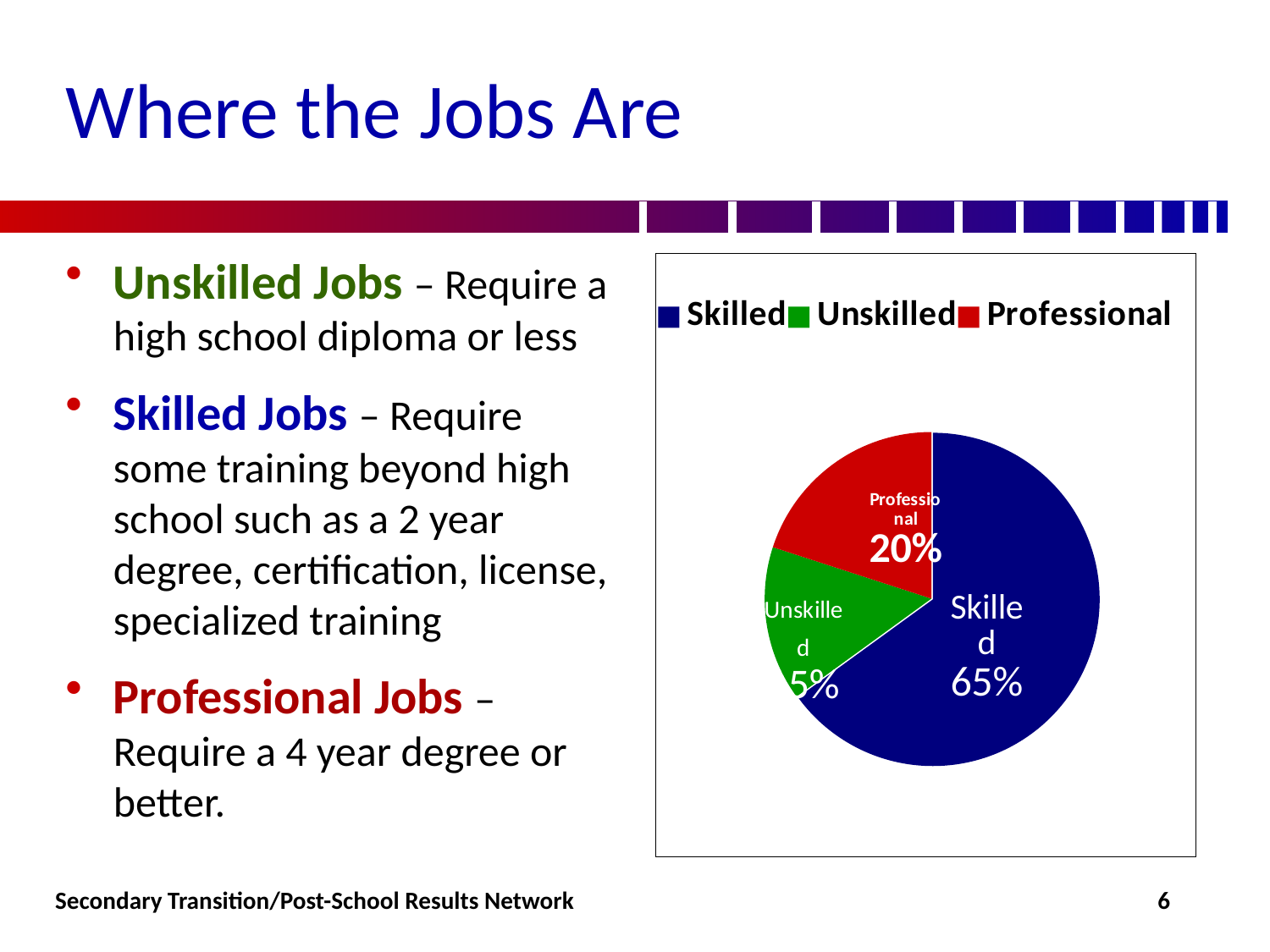
What percentage of the pie does the Professional slice represent? 20% What percentage of the pie does the Skilled slice represent? 65% Which slice is larger, Professional or Unskilled? Professional What kind of chart is shown on the slide? pie chart What colour is the Skilled slice in the pie chart? blue Which category has the smallest slice of the pie? Unskilled Which category has the largest slice of the pie? Skilled How many entries does the legend list? 3 How many slices does the pie chart have? 3 What is the difference in percentage points between the Skilled slice and the Professional slice? 45 What colour is the Unskilled slice in the pie chart? green Which slice is larger, Skilled or Professional? Skilled